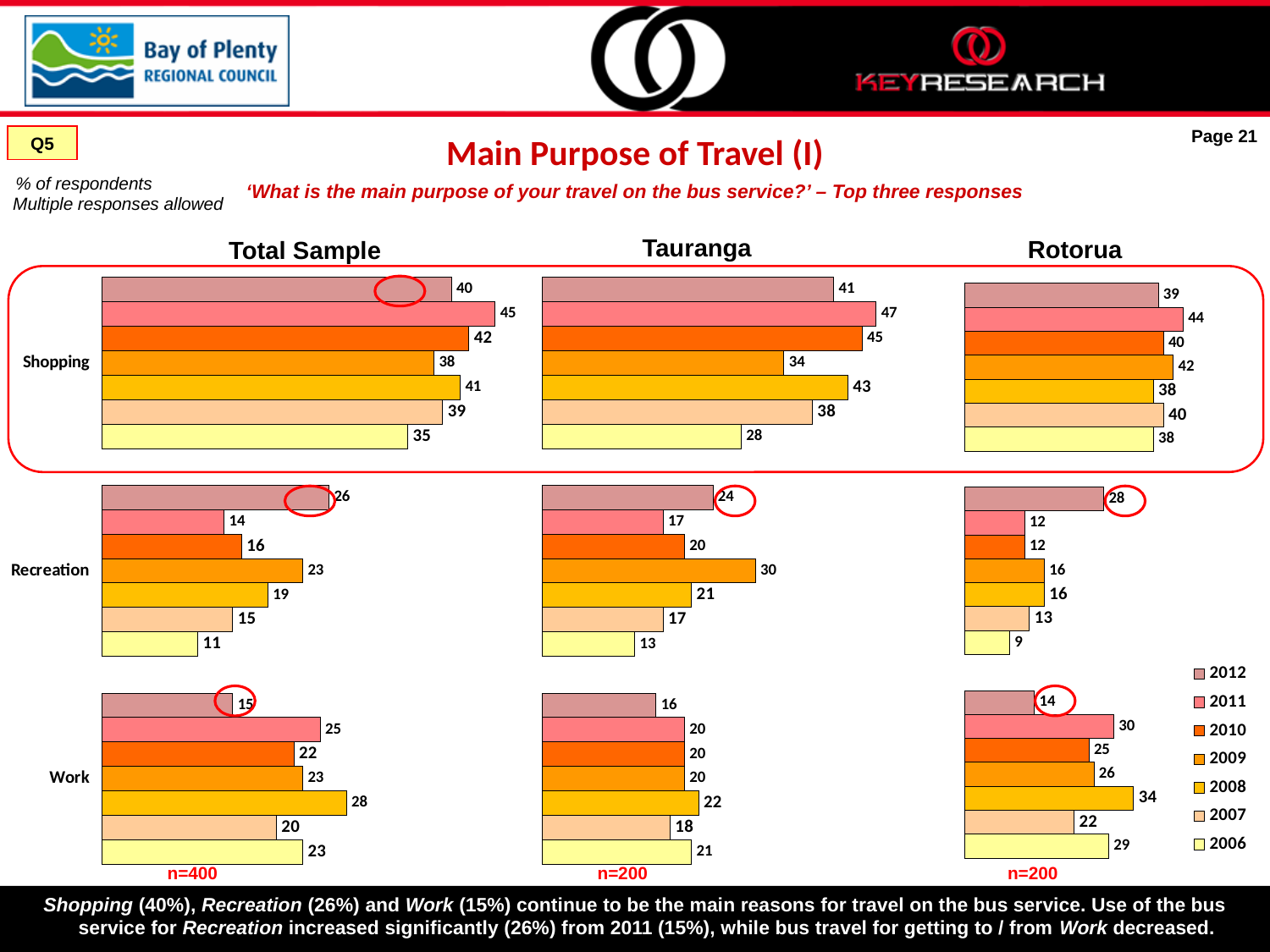
How many purpose categories are shown in the Total Sample chart? 3 What kind of chart is used for the Rotorua data? Bar chart In the Tauranga chart, which year has the lowest value for Shopping? 2006 In the Total Sample chart, which year has the highest value for Recreation? 2012 What is the sample size (n) shown under the Tauranga chart? n=200 In the Total Sample chart, which is larger: the Work value for 2008 or for 2011? 2008 In the Tauranga chart, what is the value for Shopping in 2011? 47 In the Total Sample chart, what is the value for Shopping in 2012? 40 How many series does the legend list? 7 In the Rotorua chart, what is the difference between the Work values for 2011 and 2012? 16 In the Rotorua chart, what is the value for Work in 2008? 34 In the Tauranga chart, what is the difference between the Recreation values for 2009 and 2006? 17